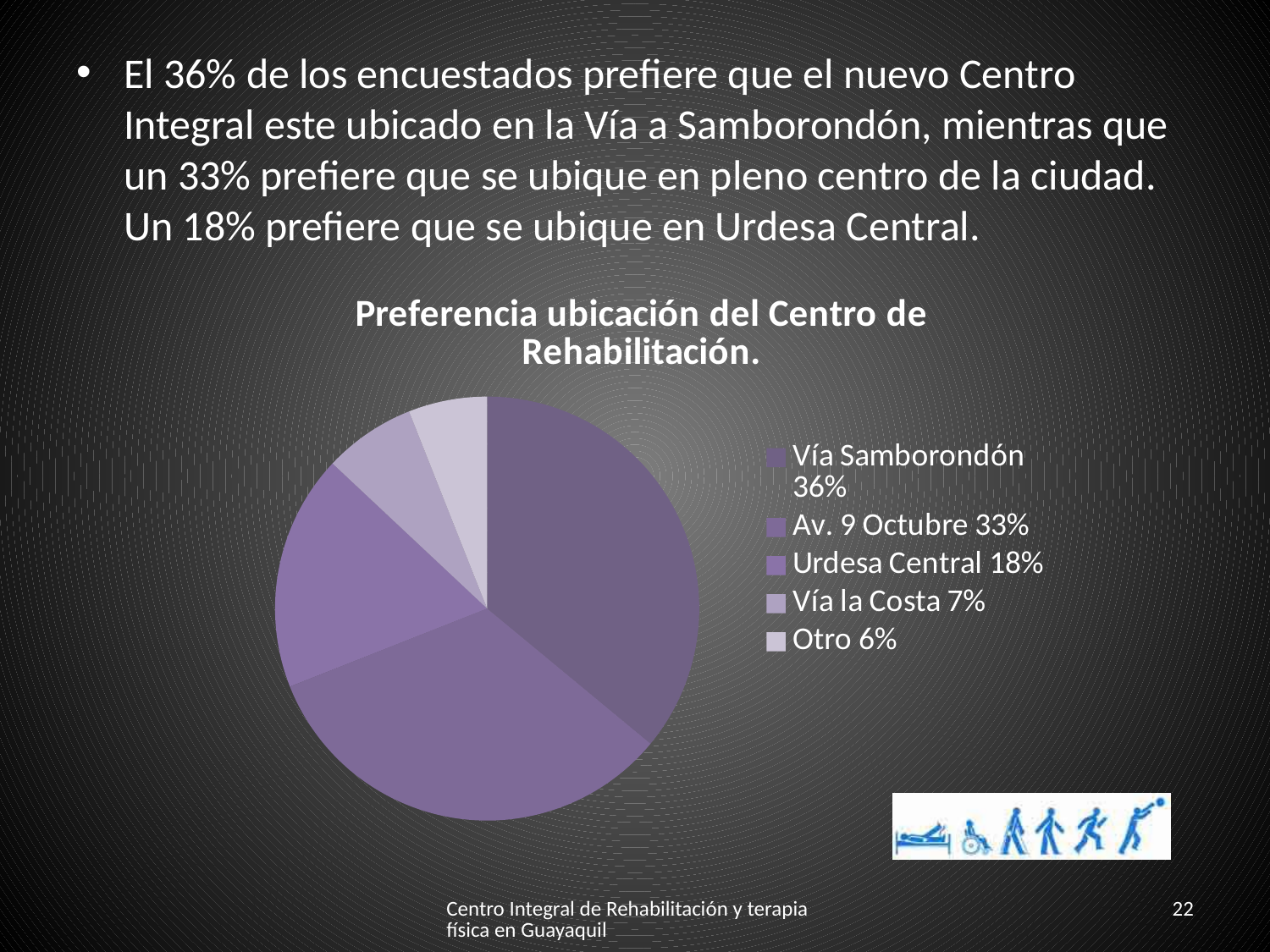
What share of the pie does Otro have? 6% Which category has the smallest share of the pie? Otro How many categories does the legend list? 5 What is the difference between the shares of Vía Samborondón and Av. 9 Octubre? 3% What share of the pie does Vía Samborondón have? 36% Which category has the largest share of the pie? Vía Samborondón What is the title of the chart? Preferencia ubicación del Centro de Rehabilitación. What share of the pie does Vía la Costa have? 7% Which is larger, the share for Urdesa Central or the share for Vía la Costa? Urdesa Central What share of the pie does Urdesa Central have? 18% What share of the pie does Av. 9 Octubre have? 33% What kind of chart is shown on the slide? pie chart